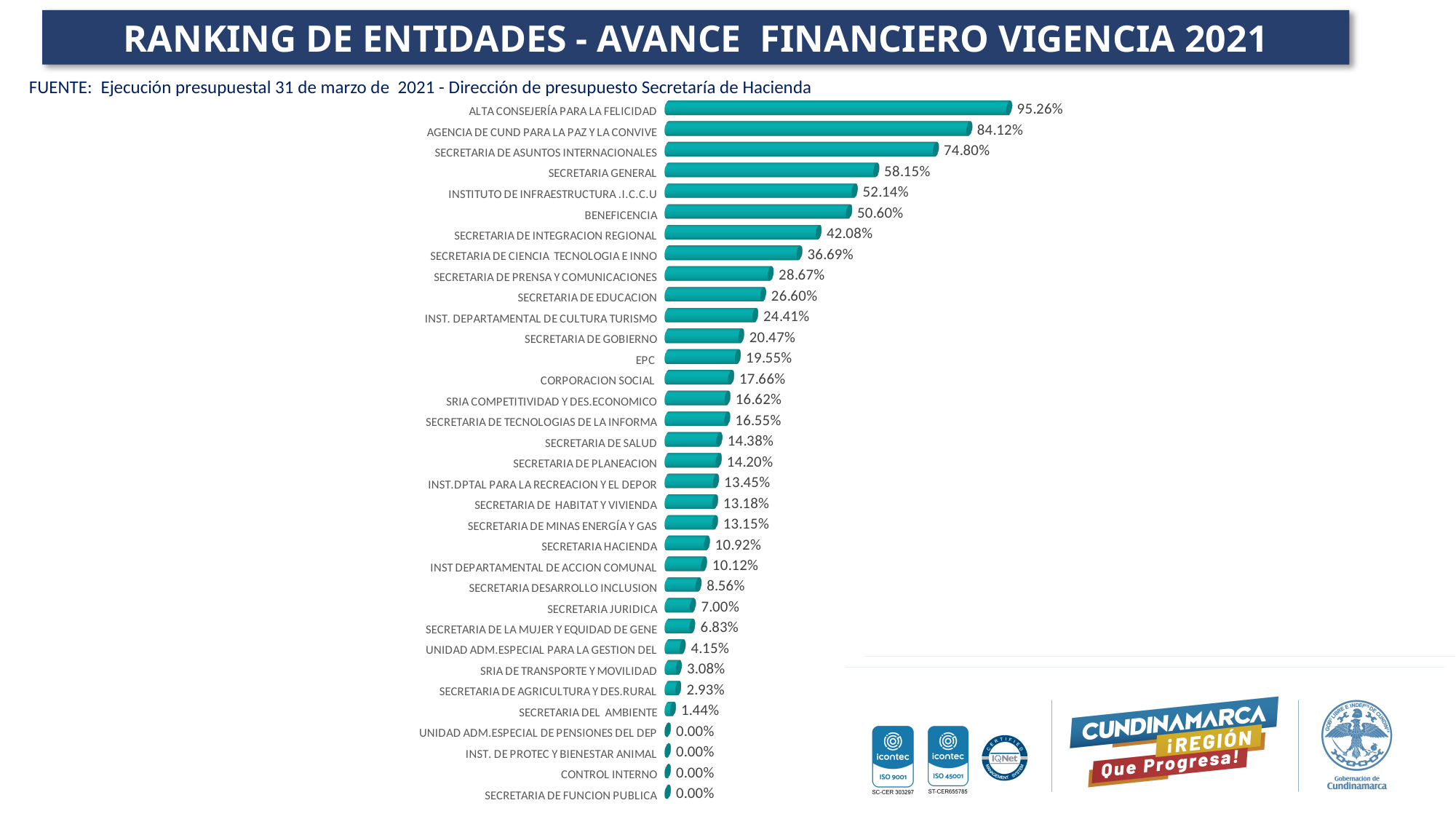
Which is larger, the value for SECRETARIA DE SALUD or the value for SECRETARIA DE GOBIERNO? SECRETARIA DE GOBIERNO What is the value for SECRETARIA DE EDUCACION? 26.60% What is the value for SECRETARIA HACIENDA? 10.92% What is the difference between the values for ALTA CONSEJERÍA PARA LA FELICIDAD and AGENCIA DE CUND PARA LA PAZ Y LA CONVIVE? 11.14% What kind of chart is shown on the slide? Bar chart What is the difference between the values for SECRETARIA GENERAL and BENEFICENCIA? 7.55% How many entities show a value of 0.00%? 4 How many entities are listed in the chart? 34 Which is larger, the value for EPC or the value for SECRETARIA JURIDICA? EPC Which entity has the highest value? ALTA CONSEJERÍA PARA LA FELICIDAD What is the title of the slide? RANKING DE ENTIDADES - AVANCE FINANCIERO VIGENCIA 2021 What is the value for ALTA CONSEJERÍA PARA LA FELICIDAD? 95.26%